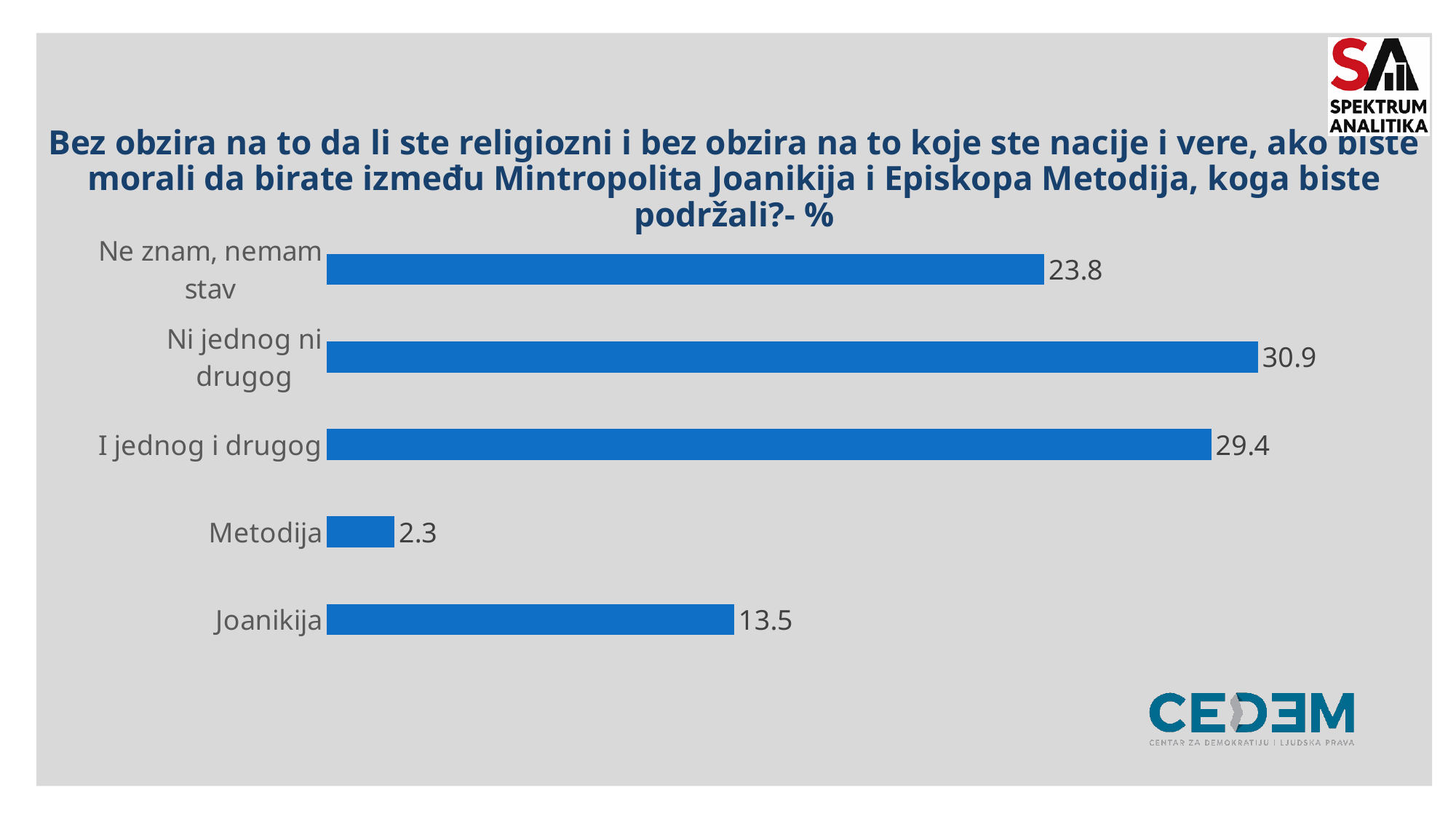
How many categories are shown in the chart? 5 What is the value for "Ne znam, nemam stav"? 23.8 Which is larger, the value for Joanikija or the value for "Ne znam, nemam stav"? Ne znam, nemam stav What kind of chart is shown on the slide? Bar chart What is the difference between the values for "Ni jednog ni drugog" and "I jednog i drugog"? 1.5 What is the value for "I jednog i drugog"? 29.4 What is the difference between the values for Joanikija and Metodija? 11.2 Which category has the lowest value? Metodija Which category has the highest value? Ni jednog ni drugog What is the value for Joanikija? 13.5 What colour are the bars in the chart? Blue What is the value for Metodija? 2.3